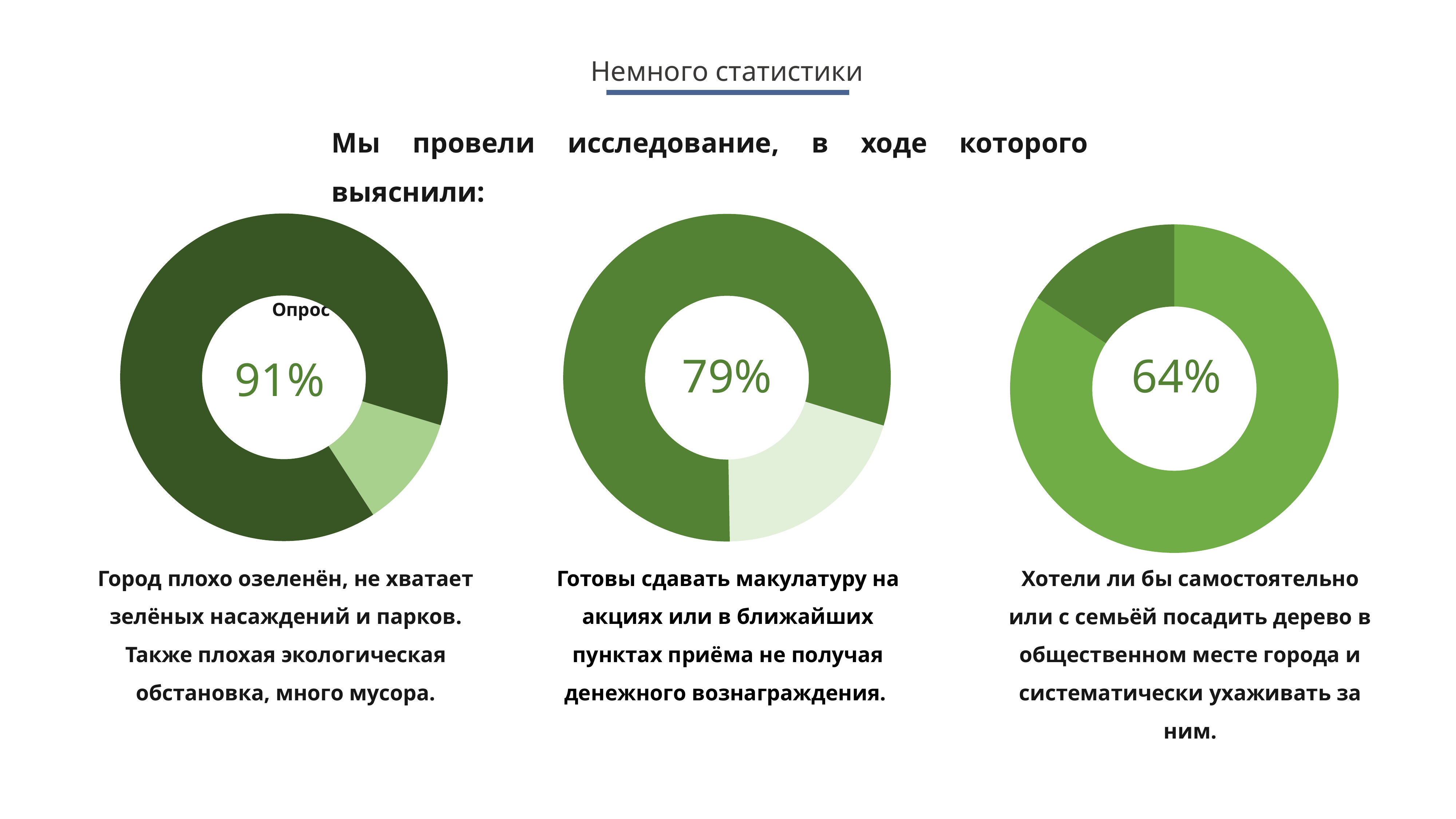
What percentage is shown in the centre of the left doughnut chart (titled "Опрос")? 91% How many charts are on the slide? 3 What percentage is shown in the centre of the middle doughnut chart? 79% What is the difference between the percentage in the middle chart (79%) and the percentage in the right chart (64%)? 15 percentage points How many slices does the left doughnut chart (titled "Опрос") have? 2 What is the difference between the percentage in the left chart (91%) and the percentage in the middle chart (79%)? 12 percentage points Is the percentage shown in the middle chart larger or smaller than the percentage shown in the right chart? Larger What is the title printed on the left doughnut chart? Опрос Which of the three charts shows the highest percentage in its centre? The left chart (91%) What percentage is shown in the centre of the right doughnut chart? 64% What kind of charts are shown on the slide? Doughnut (pie) charts Which of the three charts shows the lowest percentage in its centre? The right chart (64%)